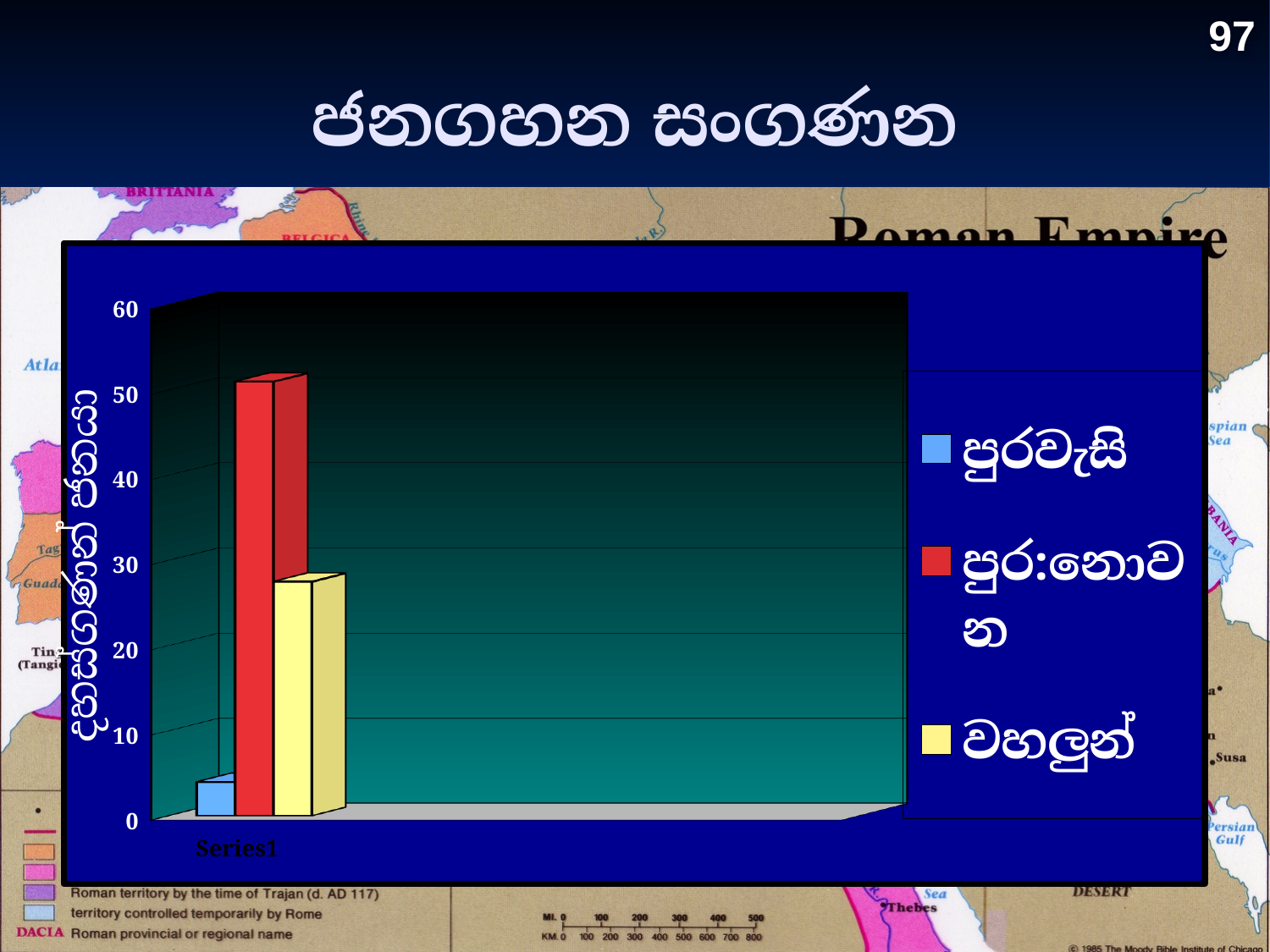
What is the category label shown under the bars on the x axis? Series1 Is the value for පුර:නොවන greater or less than 40? greater Which is larger, the bar for පුර:නොවන or the bar for වහලුන්? පුර:නොවන What colour is the bar for වහලුන්? yellow What kind of chart is shown on the slide? bar chart What is the highest value shown on the vertical axis? 60 Which is larger, the bar for වහලුන් or the bar for පුරවැසි? වහලුන් Is the value for වහලුන් greater or less than 30? less Which series has the shortest bar? පුරවැසි How many series does the legend list? 3 Is the value for පුරවැසි greater or less than 10? less Which series has the tallest bar? පුර:නොවන